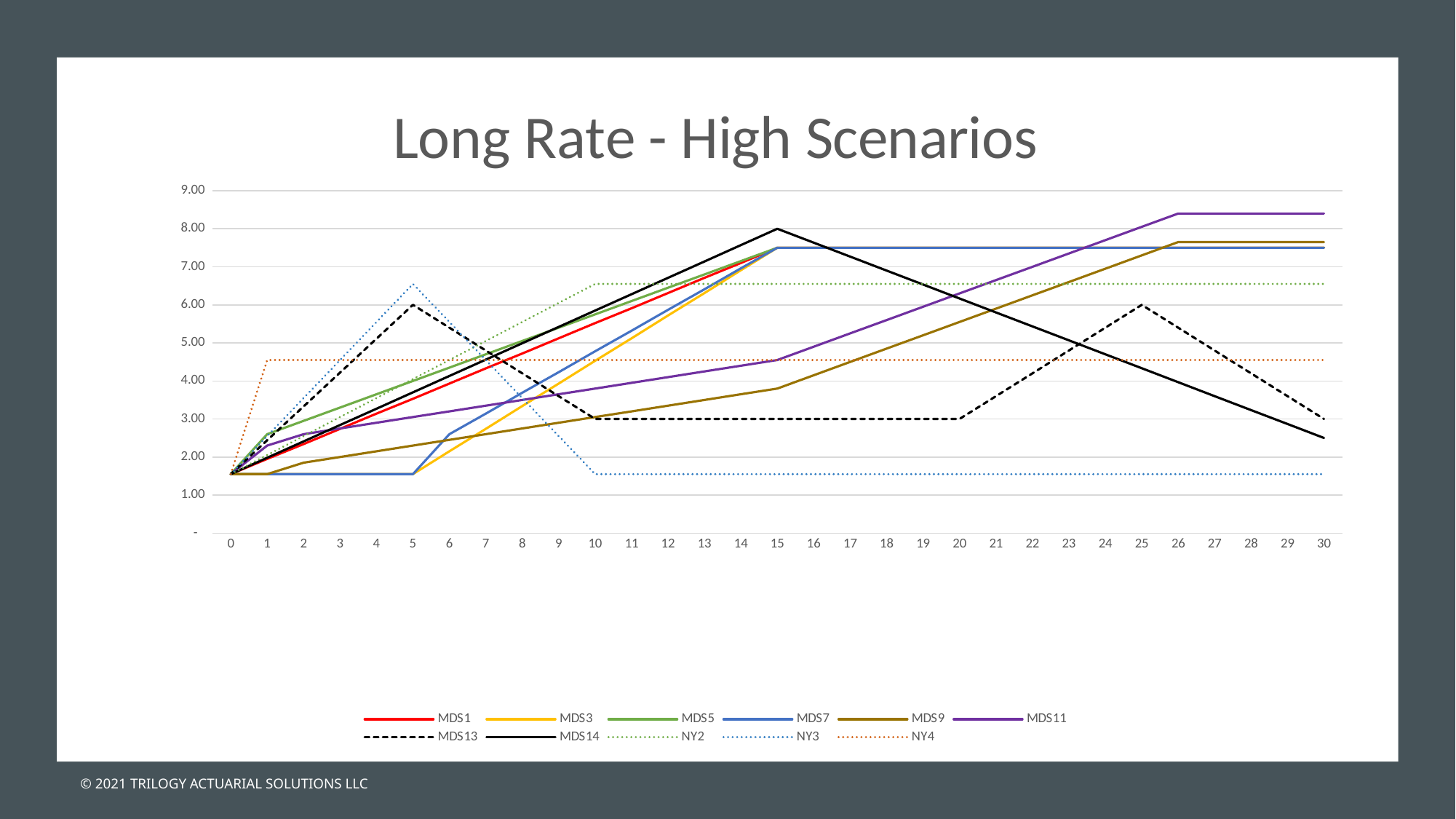
Is the value for NY3 at x = 30 greater or less than 2.00? less Which series has the highest value at x = 30? MDS11 Is the value for NY4 at x = 20 greater or less than 4.00? greater What value does the MDS13 series reach at x = 5? 6.00 At x = 30, which is larger, MDS11 or MDS14? MDS11 Which series has the lowest value at x = 30? NY3 What value does the MDS14 series reach at its peak at x = 15? 8.00 How many series does the legend list? 11 Does the MDS14 series rise or fall between x = 15 and x = 30? Fall How many points are on the x axis (from 0 to 30)? 31 What is the title of the chart? Long Rate - High Scenarios What kind of chart is shown on the slide? Line chart